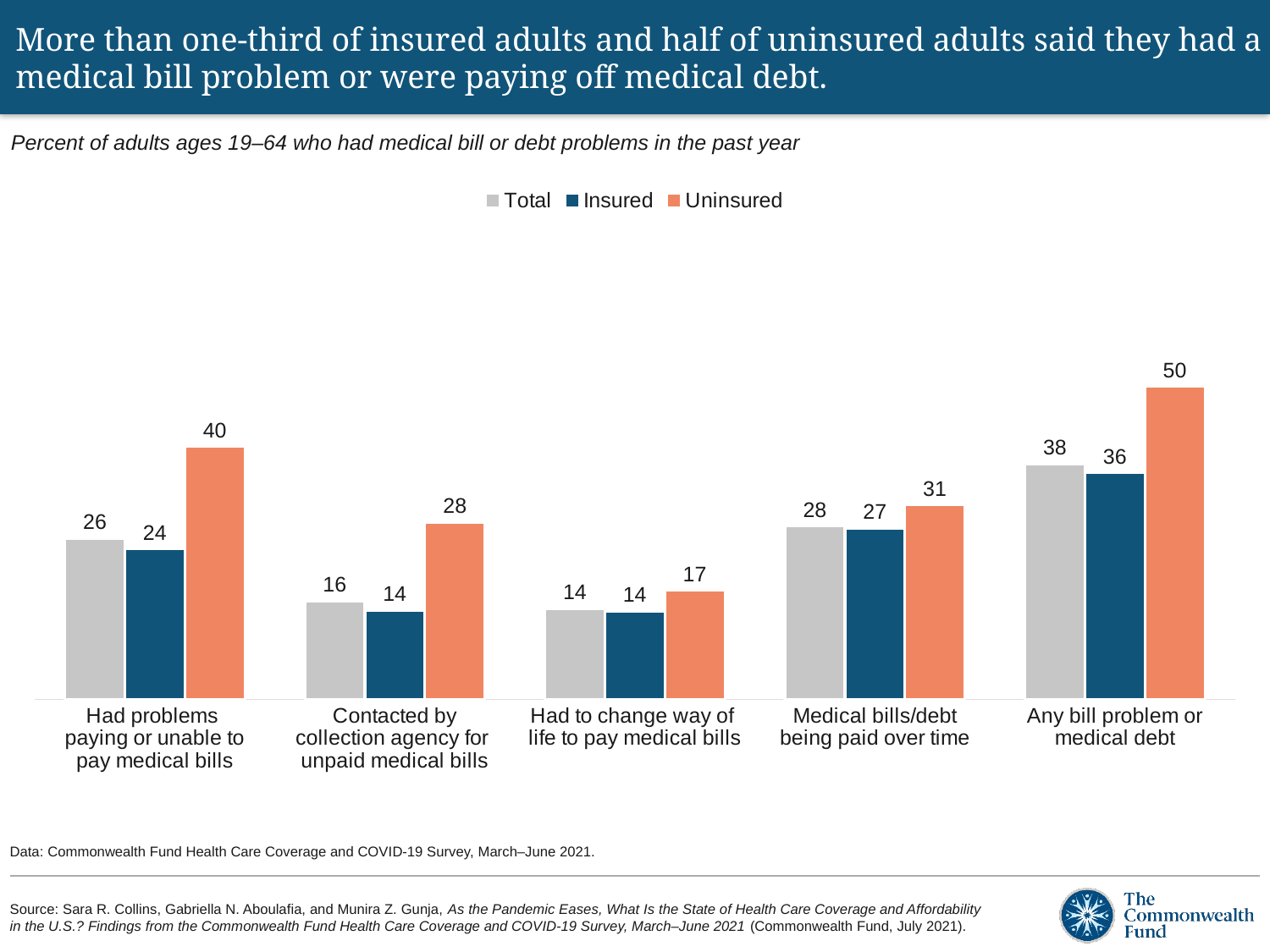
What is the Insured value for "Had problems paying or unable to pay medical bills"? 24 Which category has the lowest Total value? Had to change way of life to pay medical bills Which series is shown in orange in the legend? Uninsured What is the difference between the Uninsured and Insured values for "Had problems paying or unable to pay medical bills"? 16 What is the Total value for "Contacted by collection agency for unpaid medical bills"? 16 How many series does the legend list? 3 Which is larger for "Medical bills/debt being paid over time": the Total value or the Uninsured value? Uninsured What is the Uninsured value for "Any bill problem or medical debt"? 50 What kind of chart is shown on the slide? Bar chart Which category has the highest Uninsured value? Any bill problem or medical debt How many categories are shown on the x axis? 5 What is the difference between the Uninsured and Total values for "Contacted by collection agency for unpaid medical bills"? 12